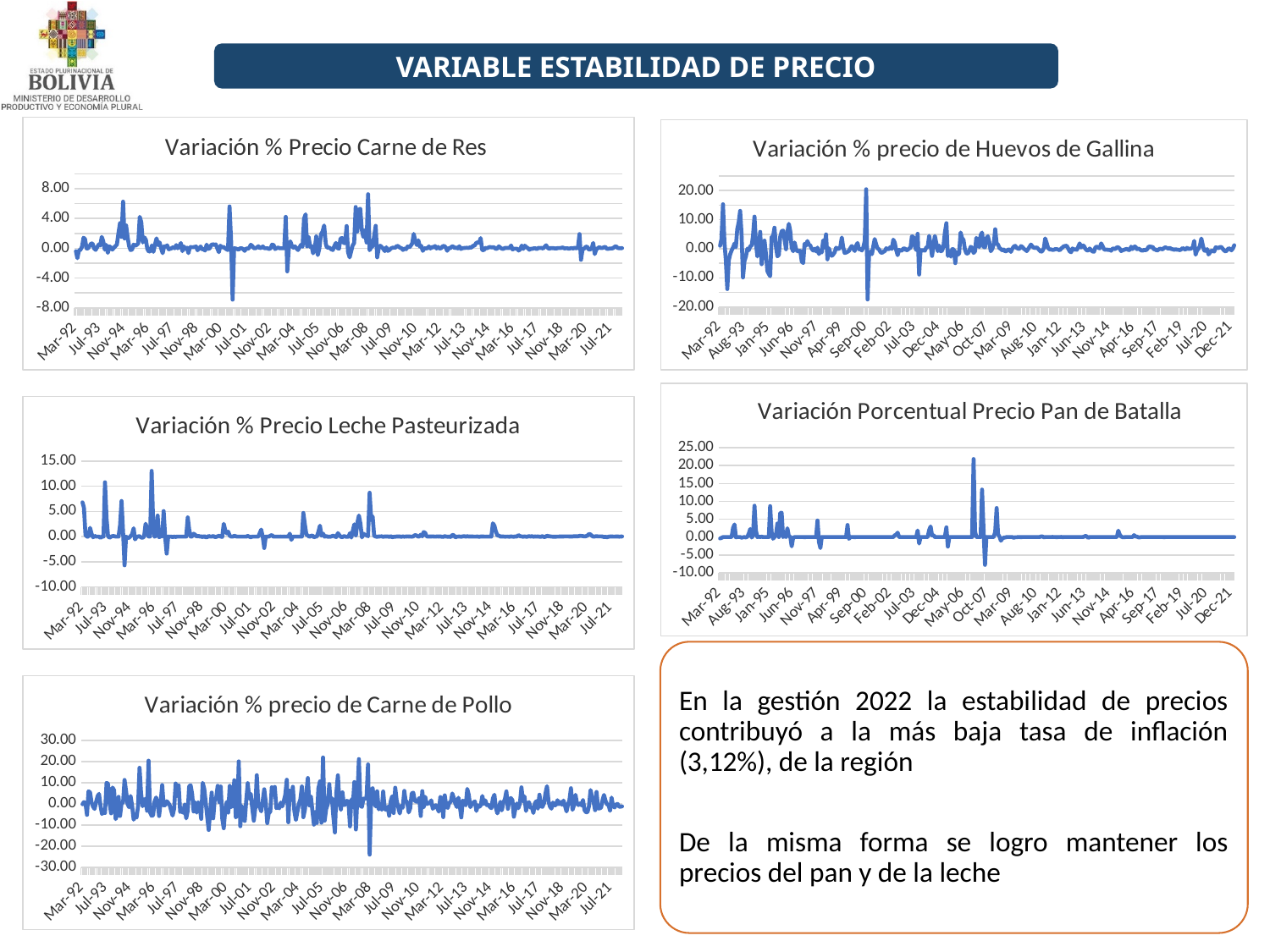
In the 'Variación % precio de Huevos de Gallina' chart, is the highest value greater or less than 10.00? greater In the 'Variación Porcentual Precio Pan de Batalla' chart, is the highest value greater or less than 15.00? greater In the 'Variación % Precio Carne de Res' chart, is the highest value greater or less than 4.00? greater What is the highest value shown on the y-axis of the 'Variación % precio de Carne de Pollo' chart? 30.00 How many charts are shown on the slide? 5 What kind of chart is 'Variación % precio de Carne de Pollo'? Line chart What kind of chart is 'Variación % Precio Carne de Res'? Line chart